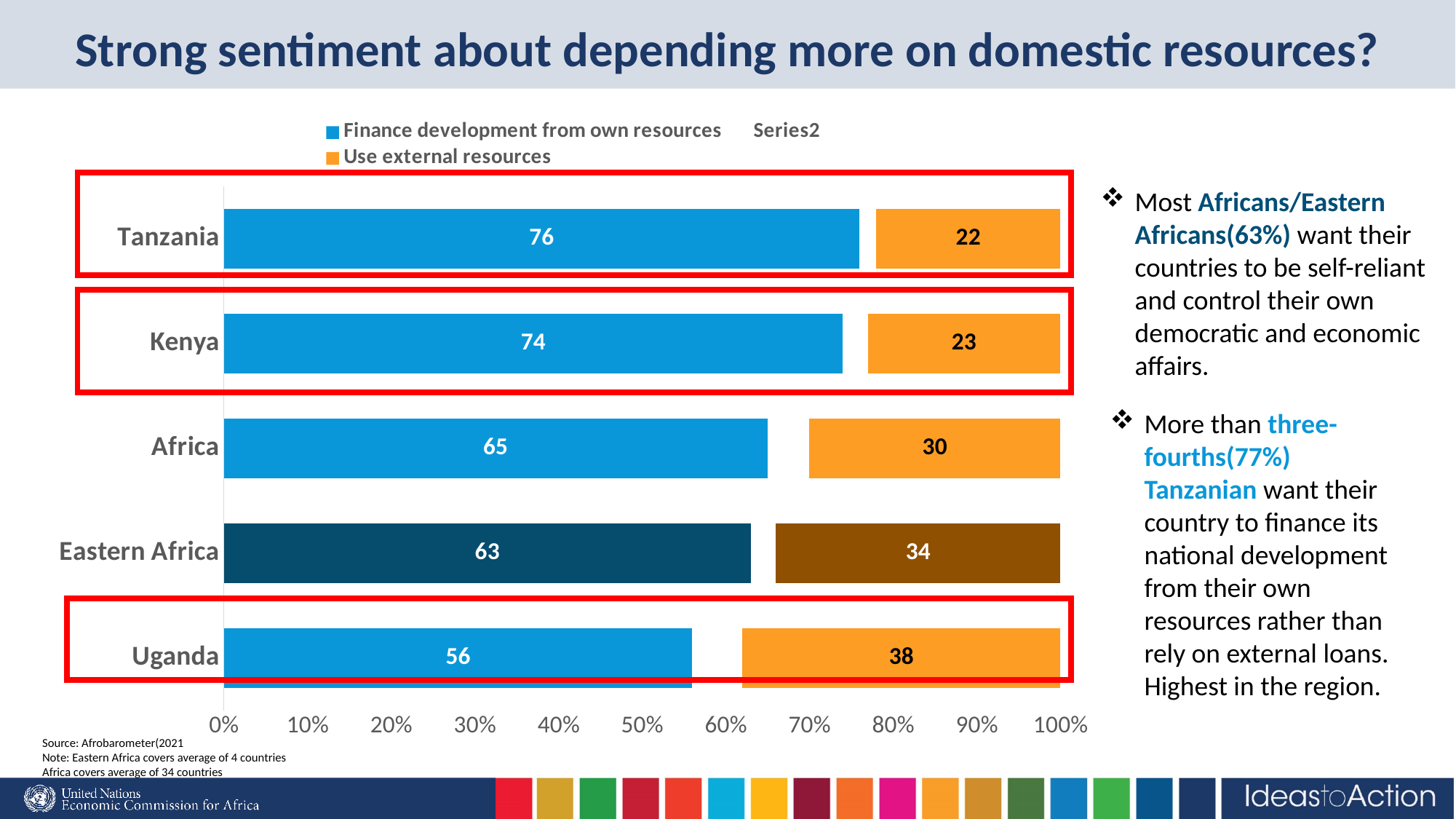
What is the difference between the 'Finance development from own resources' values for Kenya and Uganda? 18 What is the value for 'Finance development from own resources' for Tanzania? 76 What kind of chart is shown on the slide? Stacked bar chart Which category has the highest value for 'Finance development from own resources'? Tanzania Which is larger: the 'Use external resources' value for Africa or for Eastern Africa? Eastern Africa How many categories are shown on the chart? 5 What is the source cited below the chart? Afrobarometer(2021 How many series does the legend list? 3 Which category has the lowest value for 'Use external resources'? Tanzania What is the value for 'Finance development from own resources' for Eastern Africa? 63 Is the 'Finance development from own resources' value for Uganda greater or less than 60%? less What is the value for 'Use external resources' for Uganda? 38